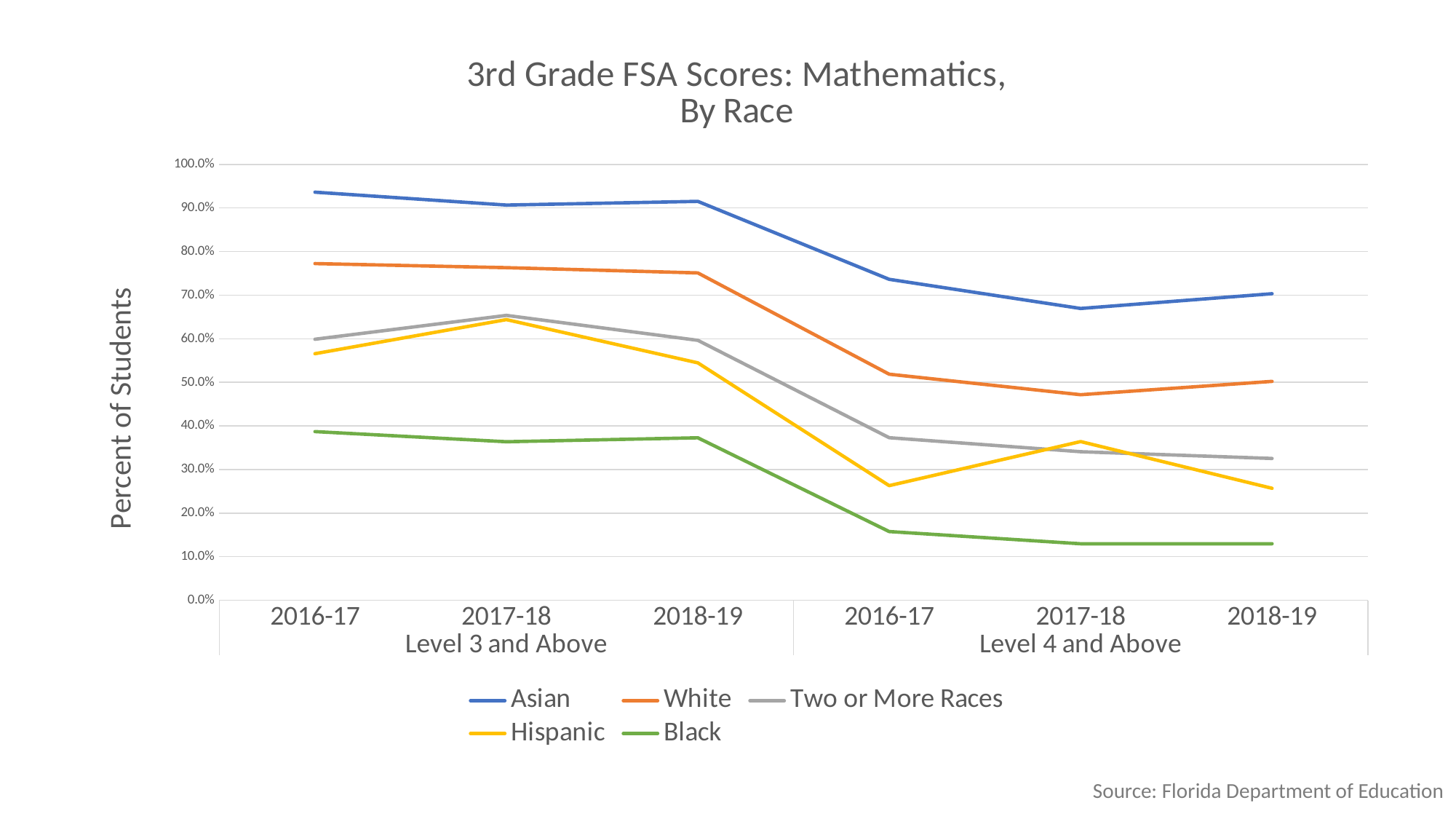
Is the value for Asian at Level 3 and Above in 2016-17 greater or less than 90.0%? greater Which race has the highest percentage of students at Level 3 and Above in 2016-17? Asian Which race has the lowest percentage of students at Level 4 and Above in 2018-19? Black Does the Asian line rise or fall from 2018-19 Level 3 and Above to 2016-17 Level 4 and Above? fall What is the label on the y axis? Percent of Students Is the value for Black at Level 4 and Above in 2016-17 greater or less than 20.0%? less Is the value for White at Level 4 and Above in 2018-19 greater or less than 60.0%? less What kind of chart is shown on the slide? line chart How many series does the legend list? 5 How many points are there along the x axis? 6 At Level 4 and Above in 2016-17, which is higher: Two or More Races or Hispanic? Two or More Races